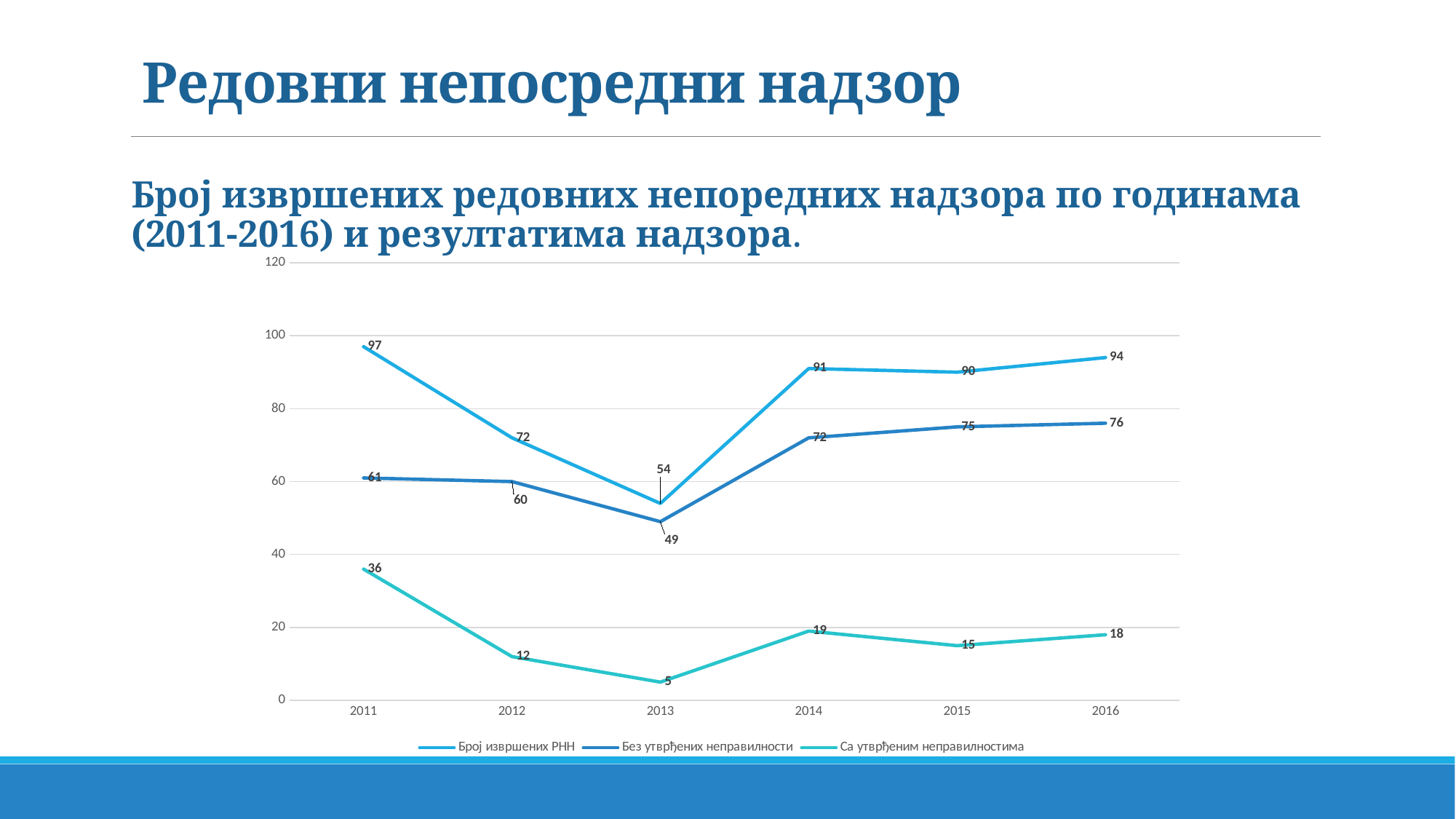
In which year is Број извршених РНН lowest? 2013 In which year is Са утврђеним неправилностима highest? 2011 How many series does the legend list? 3 Does Без утврђених неправилности rise or fall from 2013 to 2016? rise What is the value of Број извршених РНН in 2011? 97 What type of chart is shown on the slide? line chart How many years are plotted on the x axis? 6 Is the value of Број извршених РНН in 2012 greater or less than 80? less What is the value of Са утврђеним неправилностима in 2014? 19 Which is larger: Без утврђених неправилности in 2012 or in 2014? 2014 What is the value of Без утврђених неправилности in 2013? 49 What is the difference between Број извршених РНН in 2016 and in 2015? 4